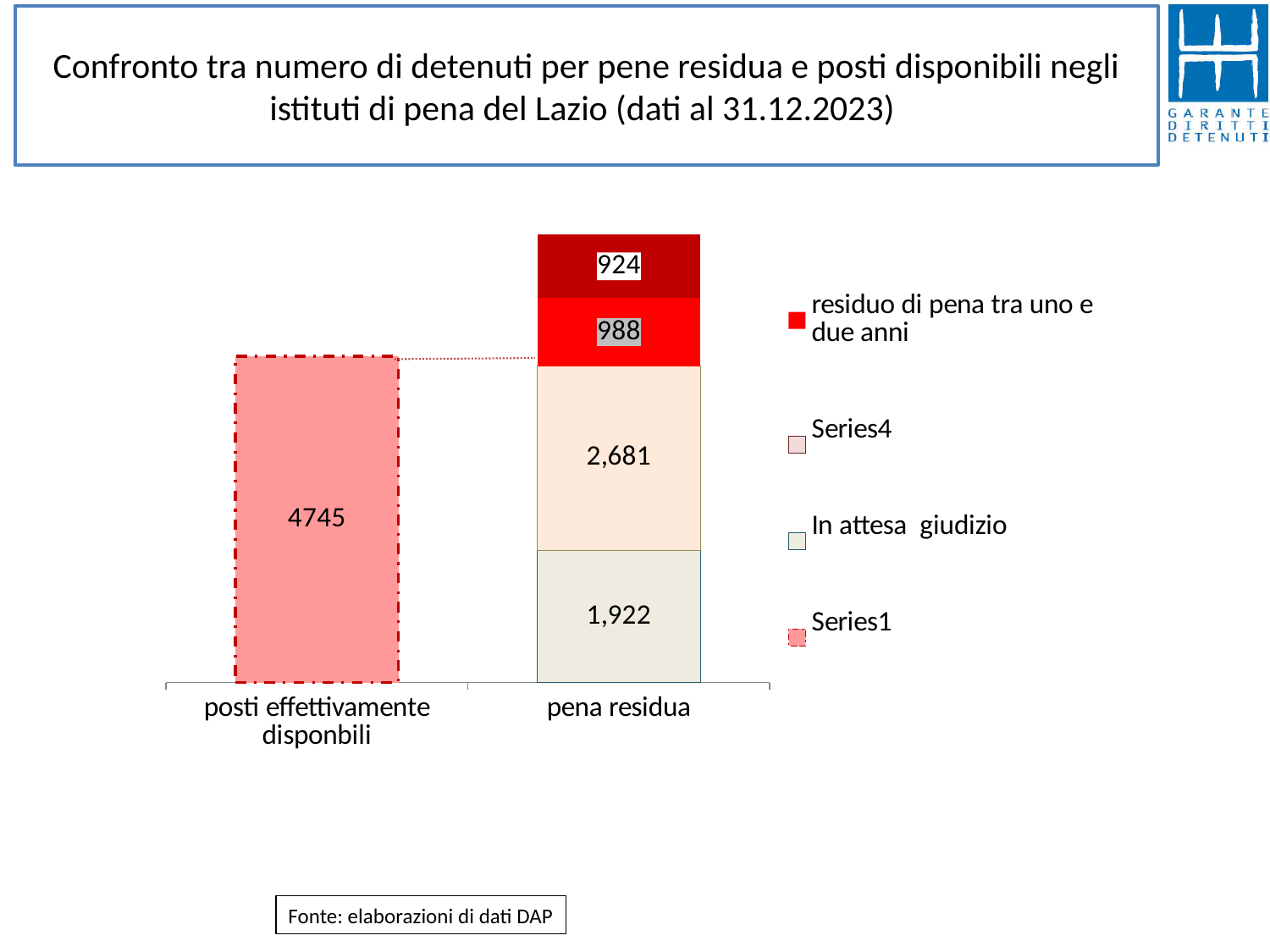
What is the value shown for 'posti effettivamente disponbili'? 4745 Which segment of the 'pena residua' bar has the largest value? The segment labeled 2,681 (second from bottom) Which is larger: the 'residuo di pena tra uno e due anni' segment or the topmost dark red segment of the 'pena residua' bar? residuo di pena tra uno e due anni (988) What is the value of the 'In attesa giudizio' segment in the 'pena residua' bar? 1,922 What kind of chart is shown on the slide? Stacked bar chart What is the difference between the 'Series4' segment (2,681) and the 'In attesa giudizio' segment (1,922)? 759 What is the value of the topmost (dark red) segment of the 'pena residua' bar? 924 What is the value of the 'residuo di pena tra uno e due anni' segment in the 'pena residua' bar? 988 How many categories are shown on the x axis? 2 What is the total of all segments in the 'pena residua' stacked bar? 6,515 How many entries does the legend list? 4